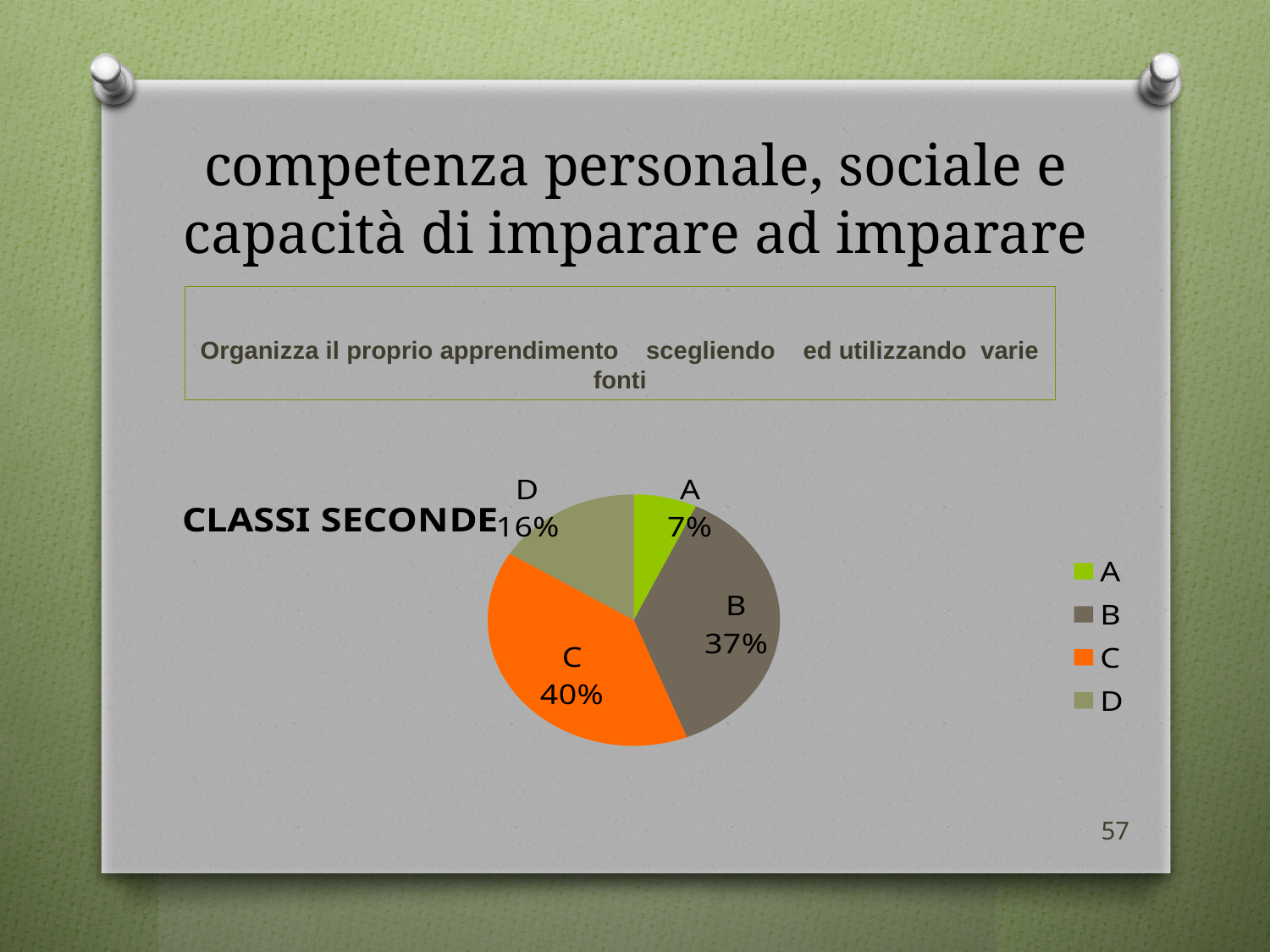
What percentage does slice D represent in the pie chart? 16% What percentage does slice C represent in the pie chart? 40% What percentage does slice A represent in the pie chart? 7% What is the difference in percentage points between slice C and slice A? 33 How many slices does the pie chart have? 4 What percentage does slice B represent in the pie chart? 37% Which slice of the pie chart is the smallest? A What kind of chart is shown on the slide? pie chart Which slice of the pie chart is the largest? C What is the difference in percentage points between slice B and slice D? 21 Which is larger, slice D or slice A? D What colour is slice C in the pie chart? orange